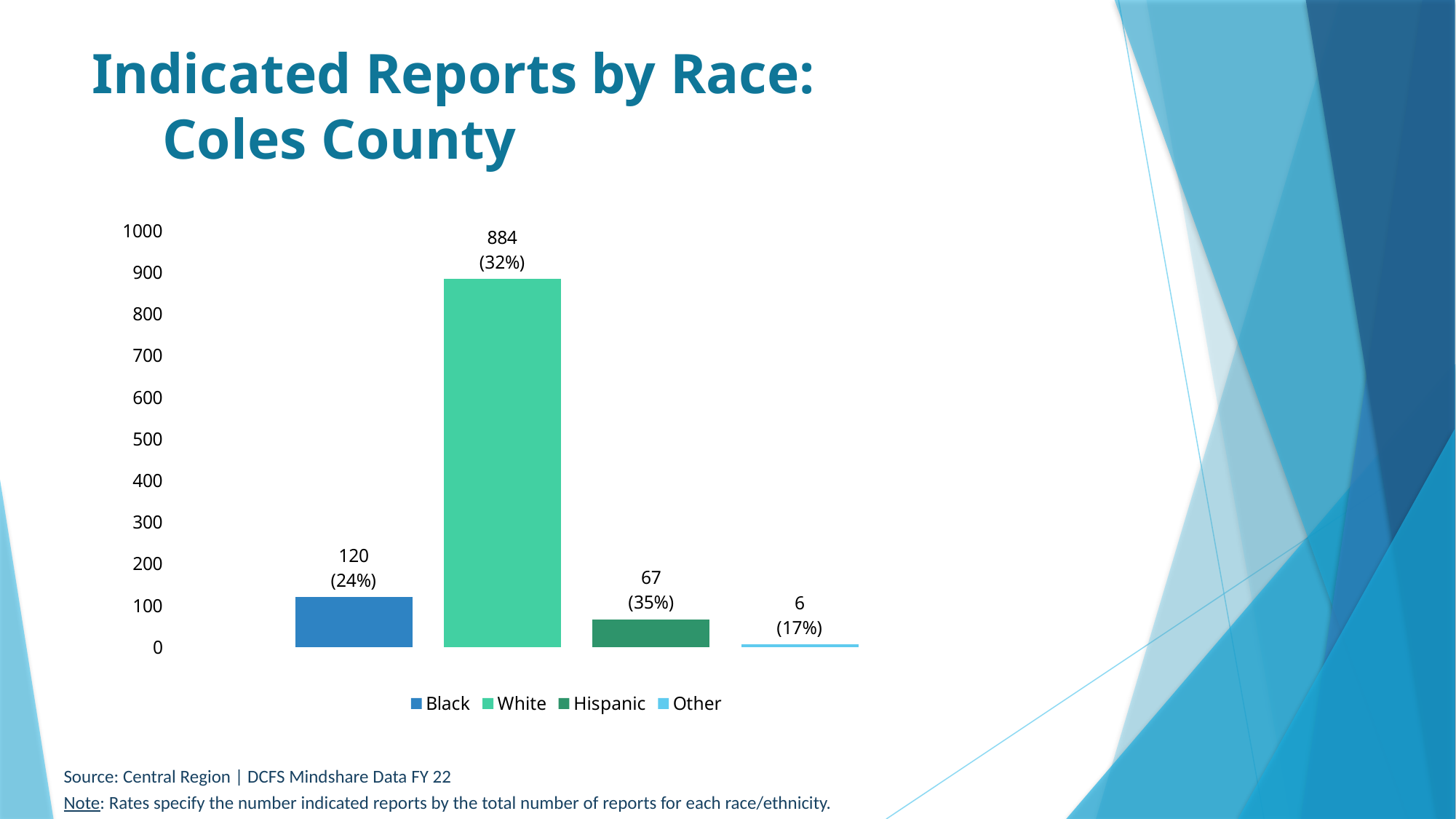
What is the total number of indicated reports across all four categories? 1077 How many race/ethnicity categories are plotted in the chart? 4 How many indicated reports are shown for Other? 6 What rate (percentage) is shown for Hispanic? 35% Is the value for White greater or less than 800? greater Which race/ethnicity has the highest number of indicated reports? White Which race/ethnicity has the lowest number of indicated reports? Other What is the difference in indicated reports between White and Black? 764 Which has more indicated reports, Black or Hispanic? Black How many indicated reports are shown for Black? 120 How many indicated reports are shown for White? 884 What kind of chart is shown on the slide? Bar chart